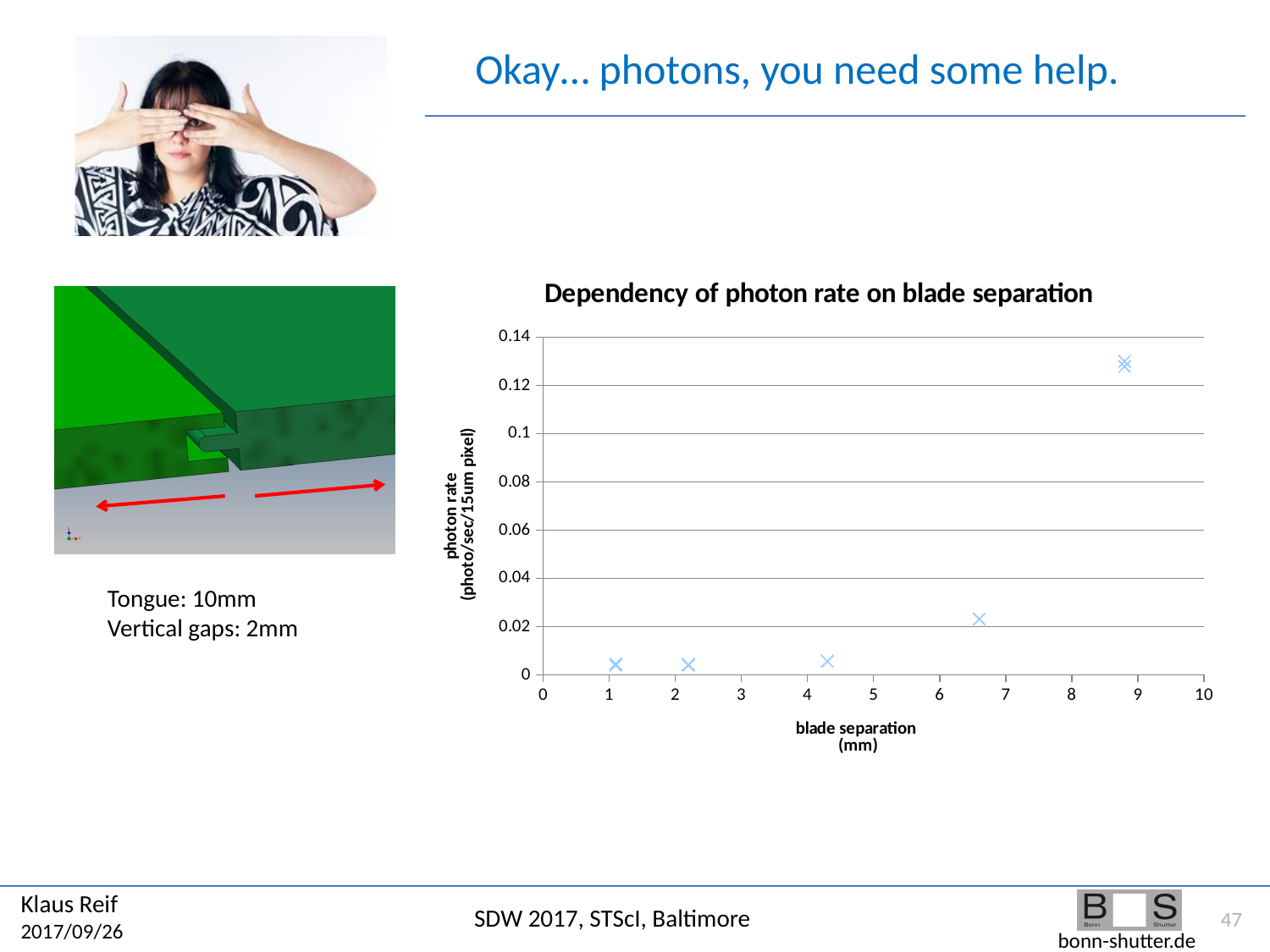
What is the label of the x axis of the chart? blade separation (mm) Is the photon rate for the point near a blade separation of 4.3 mm greater or less than 0.02? less What kind of chart is shown on the slide? scatter chart Is the photon rate for the points near a blade separation of 9 mm greater or less than 0.12? greater Is the photon rate for the point near a blade separation of 1 mm greater or less than 0.02? less Which is larger: the photon rate at a blade separation of about 6.6 mm or at about 2.2 mm? about 6.6 mm What is the highest value shown on the y axis of the chart? 0.14 What is the title of the chart? Dependency of photon rate on blade separation Does the photon rate rise or fall as blade separation increases along the x axis? rise